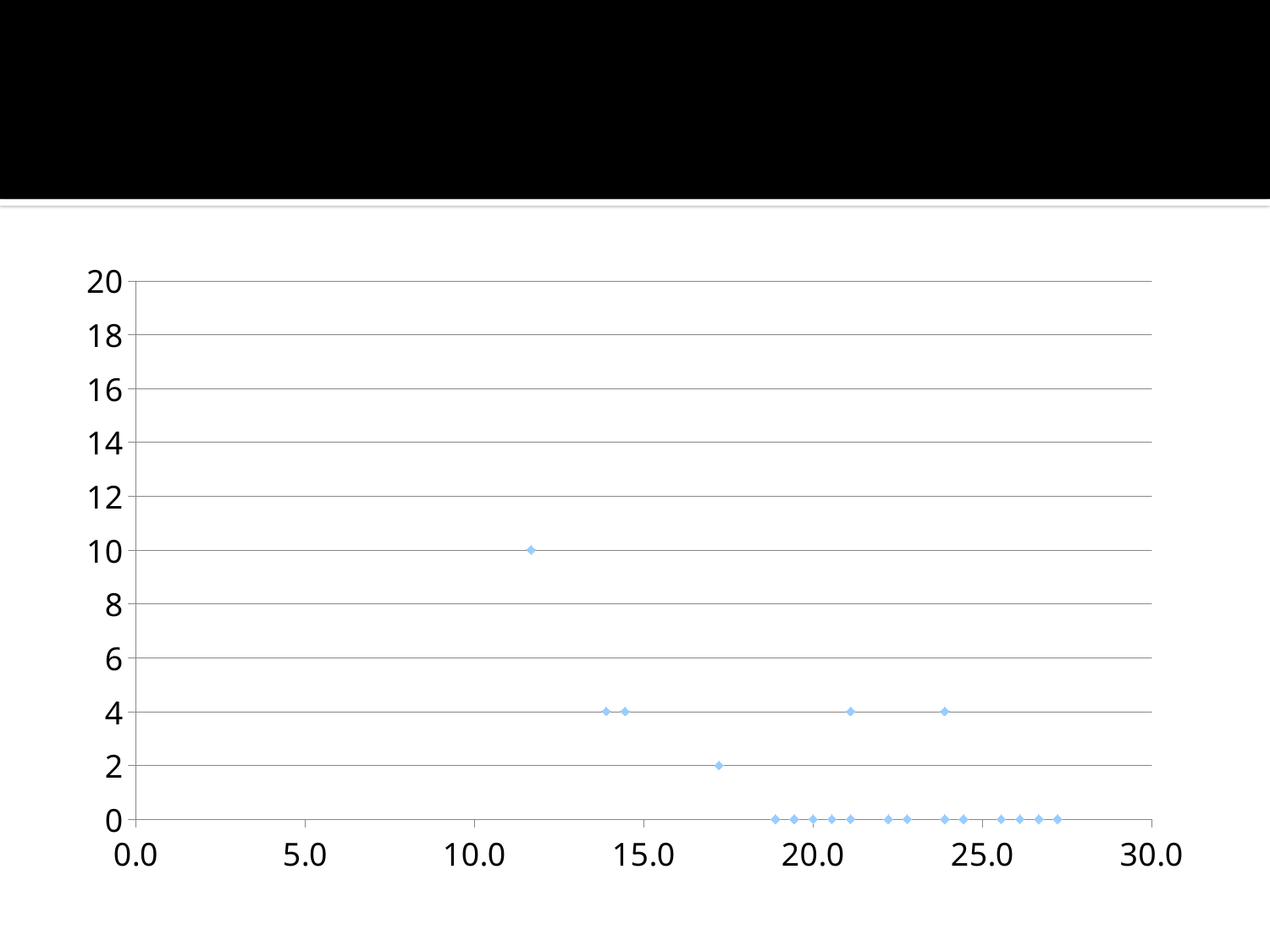
Is the y value of the leftmost point greater or less than 12? less Do the y values generally rise or fall as x increases across the chart? fall What is the lowest y value plotted on the chart? 0 What is the y value of the leftmost point on the chart? 10 What is the y value of the single point plotted between x = 15.0 and x = 20.0 that is not on the x axis? 2 What is the maximum value shown on the x axis? 30.0 Is the y value of the highest point greater or less than 8? greater What is the highest y value plotted on the chart? 10 How many points on the chart have a y value of 10? 1 Which is larger: the y value of the leftmost point or the y value of the point near x = 17? the leftmost point What kind of chart is shown on the slide? scatter chart